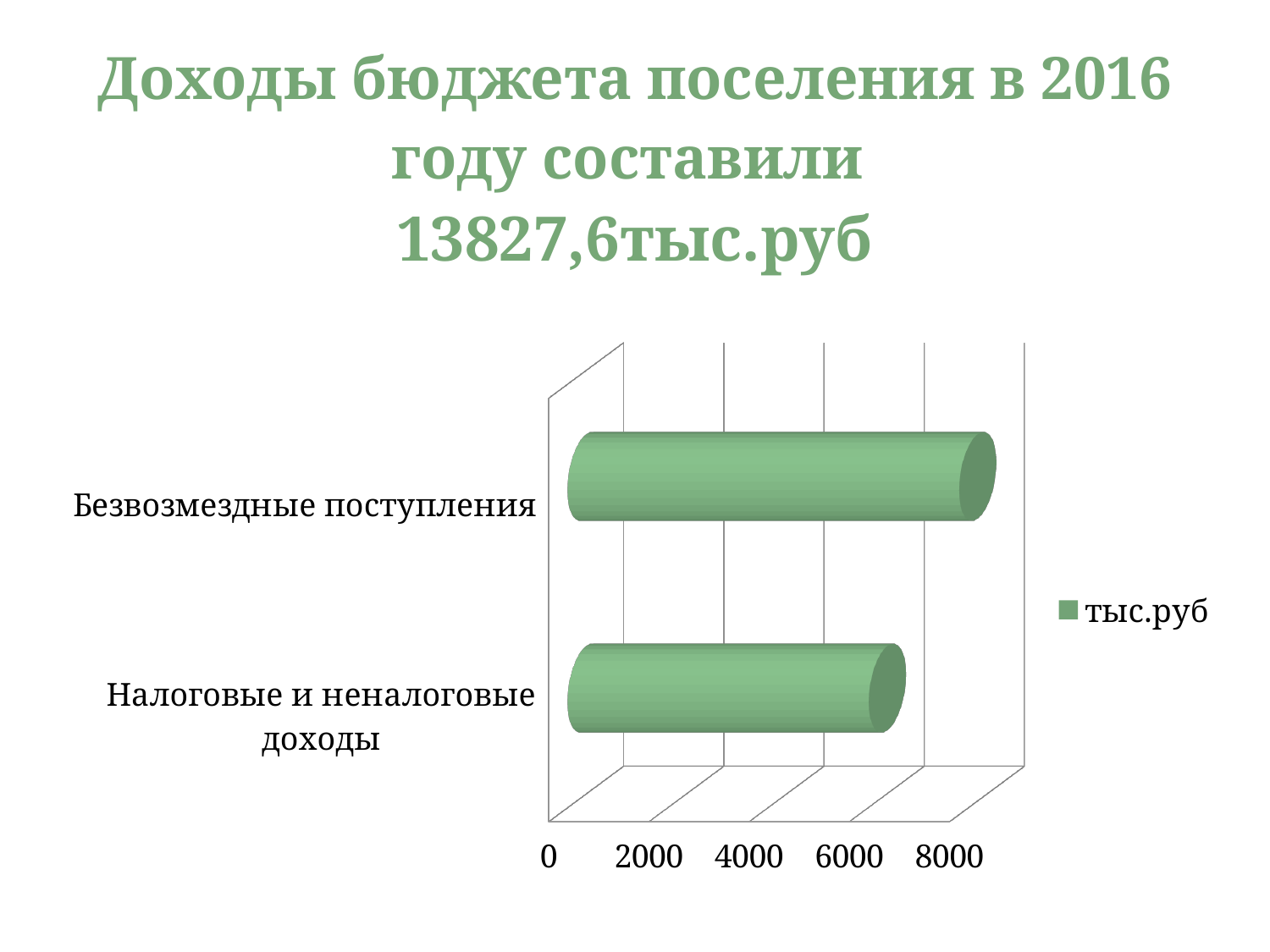
Which category has the lowest value in the chart? Налоговые и неналоговые доходы Is the value for Налоговые и неналоговые доходы greater or less than 8000? less Which category has the highest value in the chart? Безвозмездные поступления What is the legend entry of the chart? тыс.руб How many series does the legend list? 1 How many categories are plotted in the chart? 2 What kind of chart is shown on the slide? bar chart Is the value for Налоговые и неналоговые доходы greater or less than 4000? greater What total budget income for 2016 is stated in the slide title? 13827,6тыс.руб Is the value for Безвозмездные поступления greater or less than 6000? greater Which is larger: the value for Безвозмездные поступления or the value for Налоговые и неналоговые доходы? Безвозмездные поступления